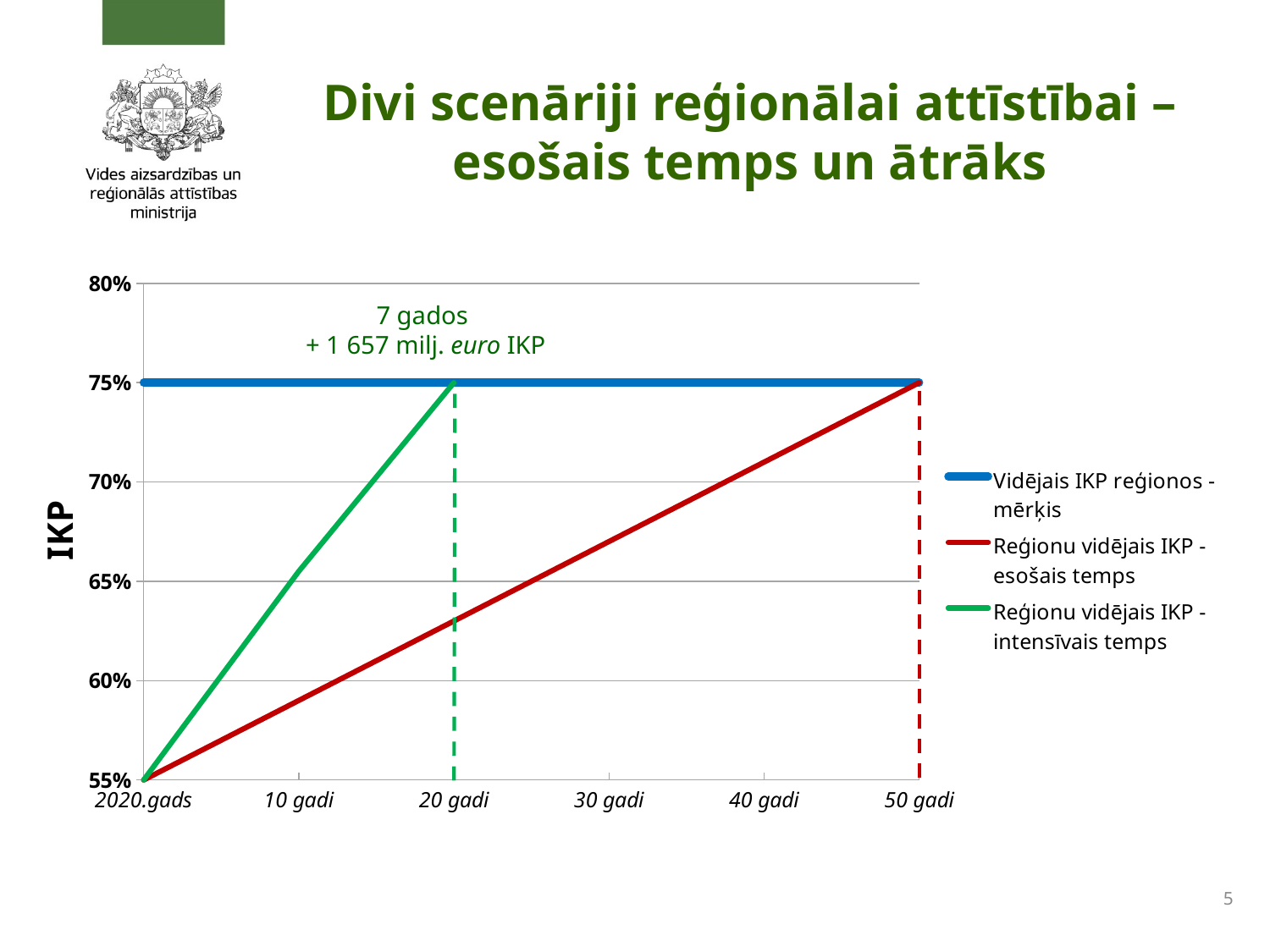
What value does the 'Vidējais IKP reģionos - mērķis' line stay at across the chart? 75% How many labels are shown on the x axis? 6 At 10 gadi, which line is higher: 'Reģionu vidējais IKP - intensīvais temps' or 'Reģionu vidējais IKP - esošais temps'? Reģionu vidējais IKP - intensīvais temps Is the value of the 'Reģionu vidējais IKP - esošais temps' line at 20 gadi greater or less than 65%? less Is the value of the 'Reģionu vidējais IKP - intensīvais temps' line at 10 gadi greater or less than 60%? greater What is the value of the 'Reģionu vidējais IKP - esošais temps' line at 2020.gads? 55% Is the value of the 'Reģionu vidējais IKP - esošais temps' line at 30 gadi greater or less than 65%? greater What value does the 'Reģionu vidējais IKP - esošais temps' line reach at 50 gadi? 75% What is the title of the y axis? IKP Does the 'Reģionu vidējais IKP - esošais temps' line rise or fall from 2020.gads to 50 gadi? rise How many series does the legend list? 3 What kind of chart is shown on the slide? line chart